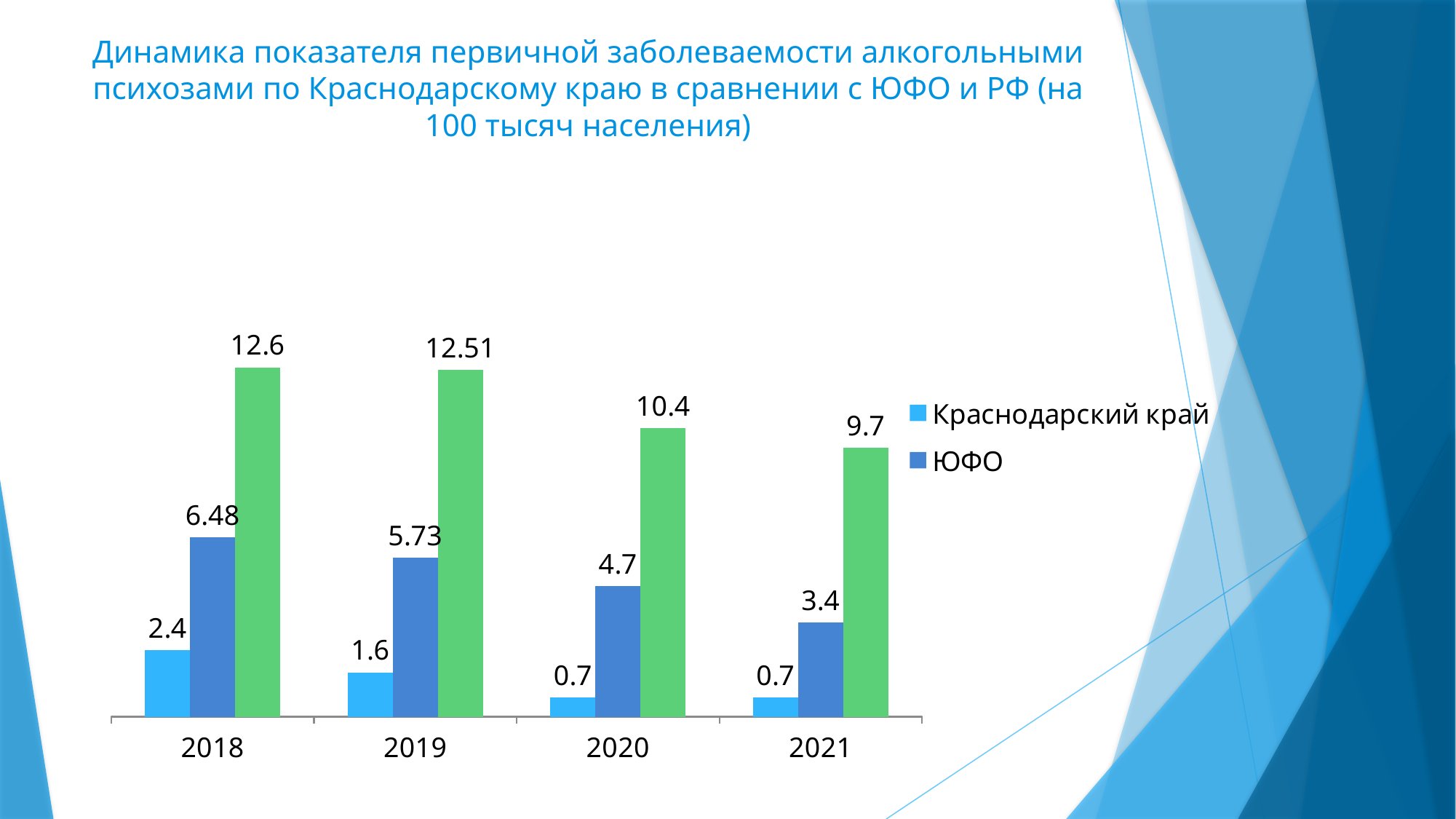
What is the value for ЮФО in 2021? 3.4 How many years are shown on the x axis? 4 In which year is the value for ЮФО the highest? 2018 Do the values for ЮФО rise or fall from 2018 to 2021? Fall What is the difference between the Краснодарский край values for 2018 and 2019? 0.8 In 2020, which is larger: the value for ЮФО or the value for Краснодарский край? ЮФО What is the value for ЮФО in 2019? 5.73 In which year is the value for ЮФО the lowest? 2021 What is the value for Краснодарский край in 2018? 2.4 How many series does the legend list? 2 What kind of chart is shown on the slide? Bar chart What is the difference between the ЮФО values for 2018 and 2021? 3.08